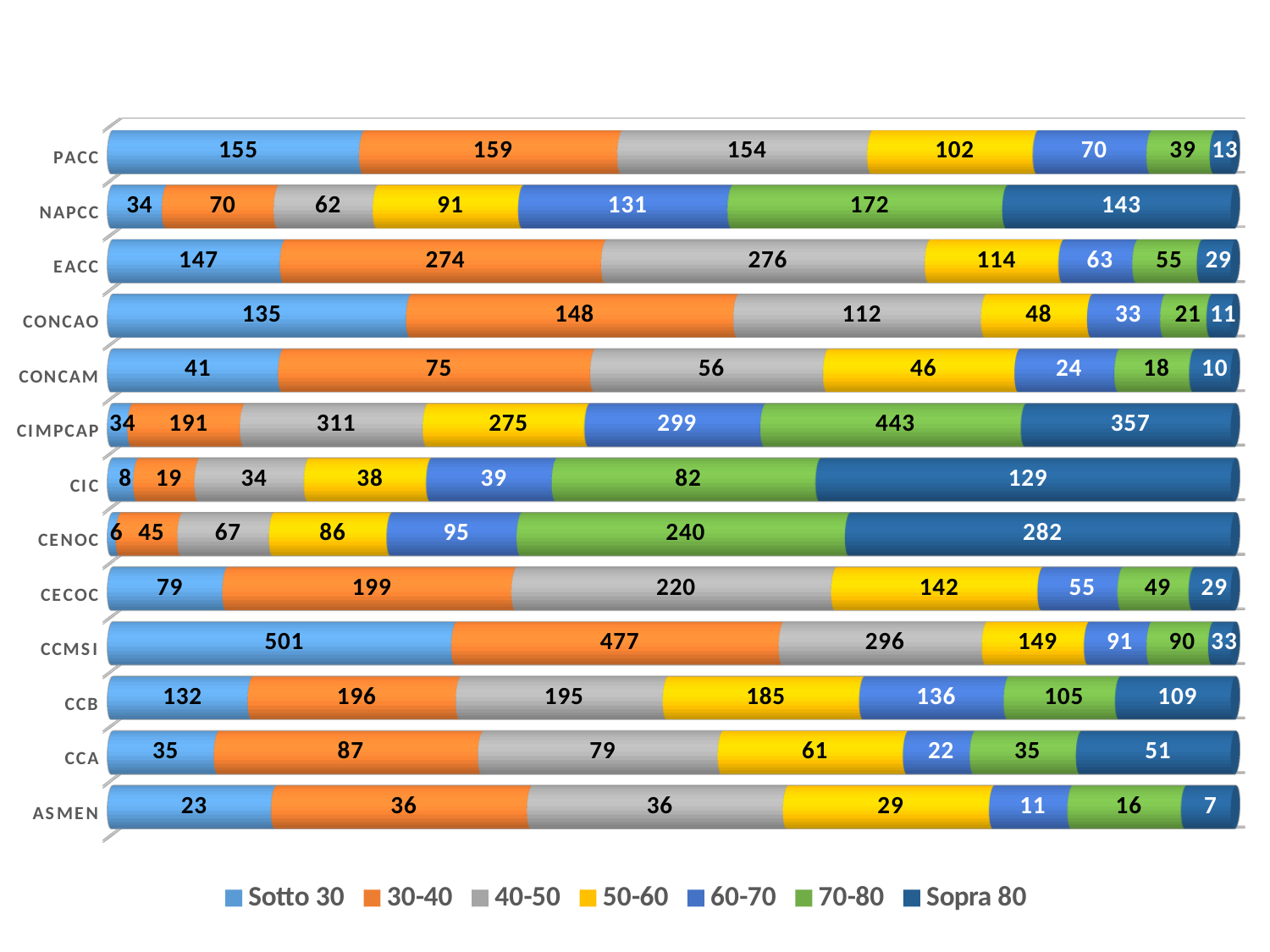
What is the total of all segments in the ASMEN bar? 158 Which category has the highest value in the Sotto 30 series? CCMSI For CIMPCAP, what is the difference between the 70-80 value and the Sopra 80 value? 86 What is the value of the Sopra 80 series for CENOC? 282 Which category has the lowest value in the Sopra 80 series? ASMEN How many series does the legend list? 7 What is the value of the 40-50 series for EACC? 276 For NAPCC, which is larger: the 70-80 value or the Sopra 80 value? 70-80 What kind of chart is shown on the slide? Stacked bar chart What is the value of the 50-60 series for CCB? 185 What is the total of all segments in the CIC bar? 349 How many categories are shown on the vertical axis? 13